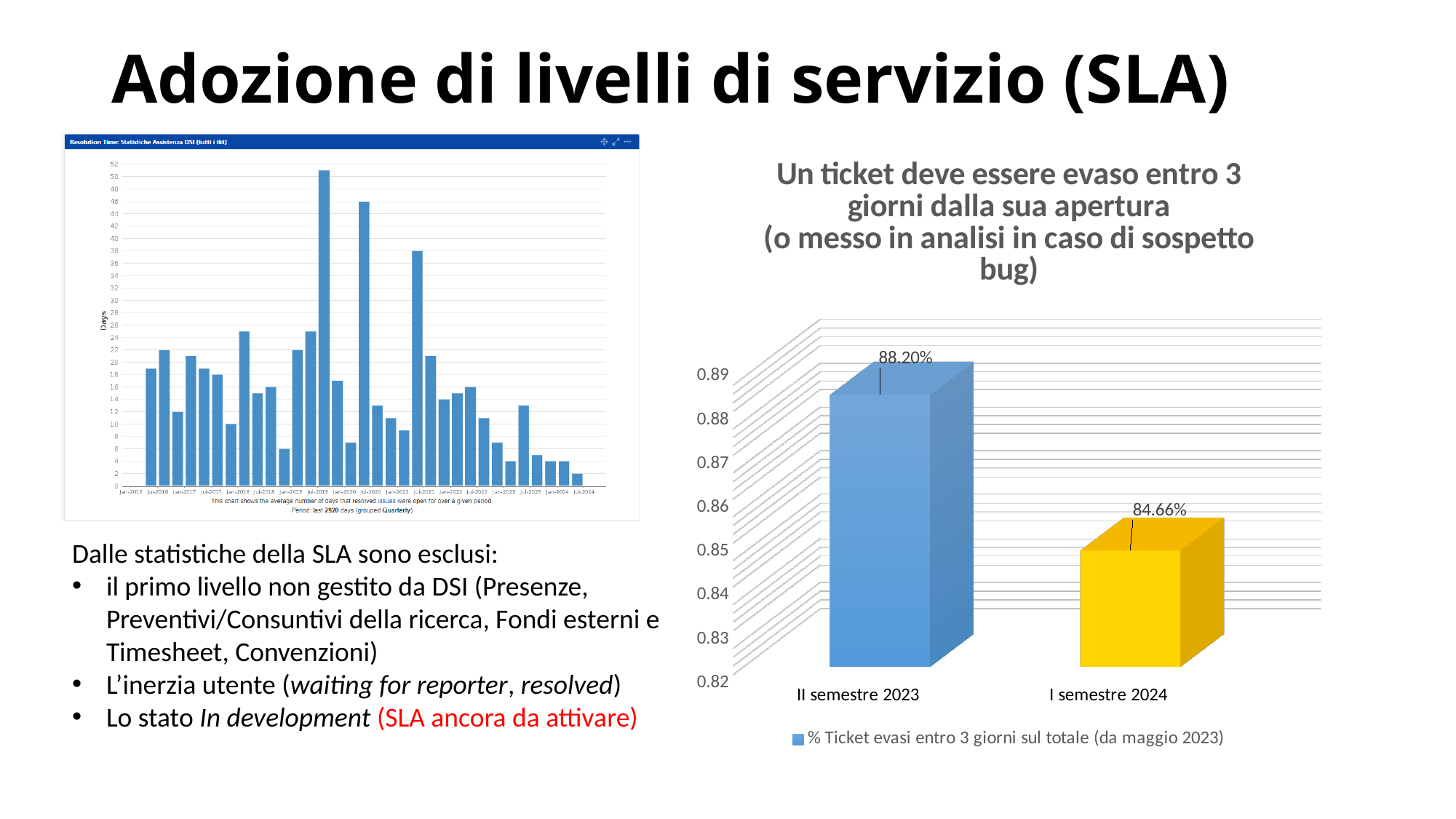
On the right chart, what series name does the legend show? % Ticket evasi entro 3 giorni sul totale (da maggio 2023) On the right chart, what is the value for II semestre 2023? 88.20% On the right chart, what is the value for I semestre 2024? 84.66% What kind of chart is the right chart? bar chart On the right chart, how many categories are plotted? 2 On the right chart, which category has the lower value? I semestre 2024 On the right chart, what is the difference between the values for II semestre 2023 and I semestre 2024? 3.54% On the left chart (Resolution Time), is the value for Jul-2024 greater or less than 10? less On the left chart (Resolution Time), which quarter has the highest bar? Jul-2019 On the right chart, which category has the higher value? II semestre 2023 On the right chart, do the values rise or fall from II semestre 2023 to I semestre 2024? fall